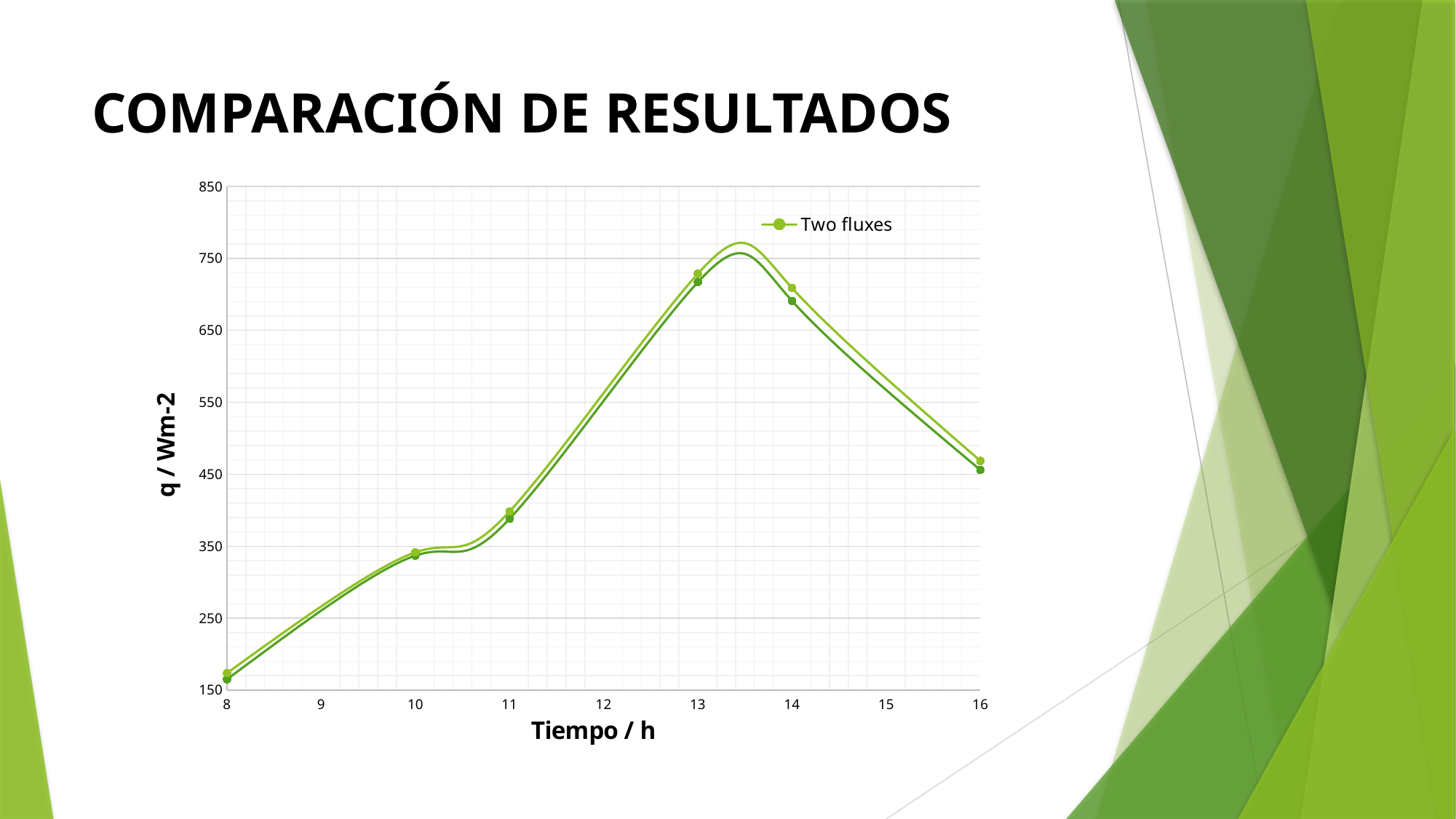
Does the Two fluxes series rise or fall between time 14 and time 16? fall Does the Two fluxes series rise or fall between time 8 and time 13? rise Is the value of the Two fluxes series at time 11 greater or less than 350? greater Is the value of the Two fluxes series at time 13 greater or less than 650? greater Is the value of the Two fluxes series at time 16 greater or less than 550? less How many series does the chart legend list? 1 What kind of chart is shown on the slide? line chart At which time does the Two fluxes series have its lowest value? 8 What is the label of the x axis? Tiempo / h What is the name of the series listed in the legend? Two fluxes How many marked data points does the Two fluxes series have? 6